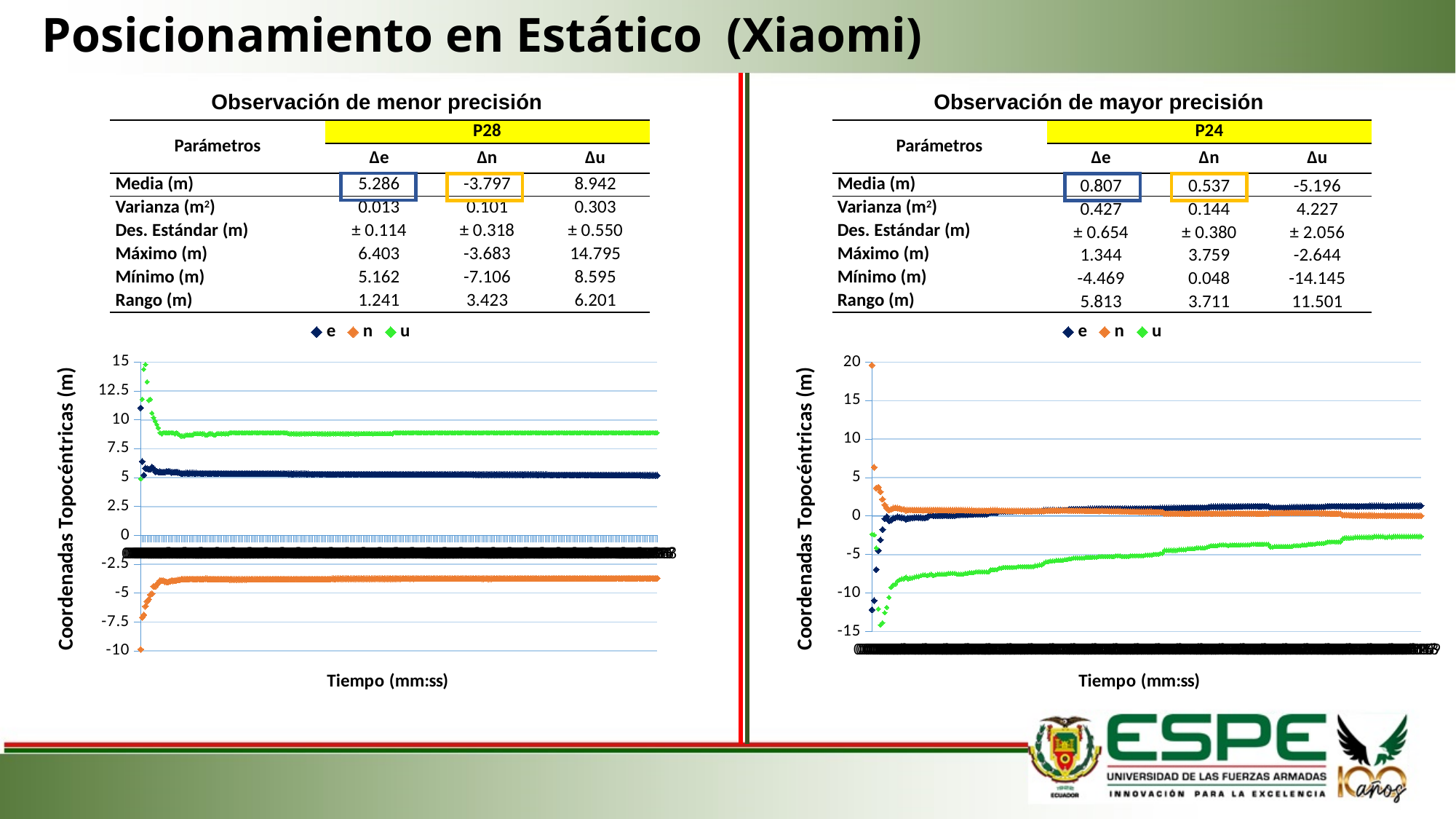
In the left chart (Observación de menor precisión), how many series does the legend list? 3 In the right chart (Observación de mayor precisión), which series has the single highest plotted point? n In the right chart (Observación de mayor precisión), does the u series rise or fall over time after its initial points? rises In the left chart (Observación de menor precisión), is the steady value of the n series greater or less than -2.5? less In the left chart (Observación de menor precisión), is the steady value of the u series greater or less than 7.5? greater In the left chart (Observación de menor precisión), which series has the highest values over most of the time range? u In the left chart (Observación de menor precisión), is the steady value of the e series greater or less than 2.5? greater What is the x-axis title of the right chart (Observación de mayor precisión)? Tiempo (mm:ss) In the left chart (Observación de menor precisión), which series has the lowest values over most of the time range? n In the right chart (Observación de mayor precisión), what are the series names in the legend? e, n, u What kind of chart is the left chart (Observación de menor precisión)? scatter chart